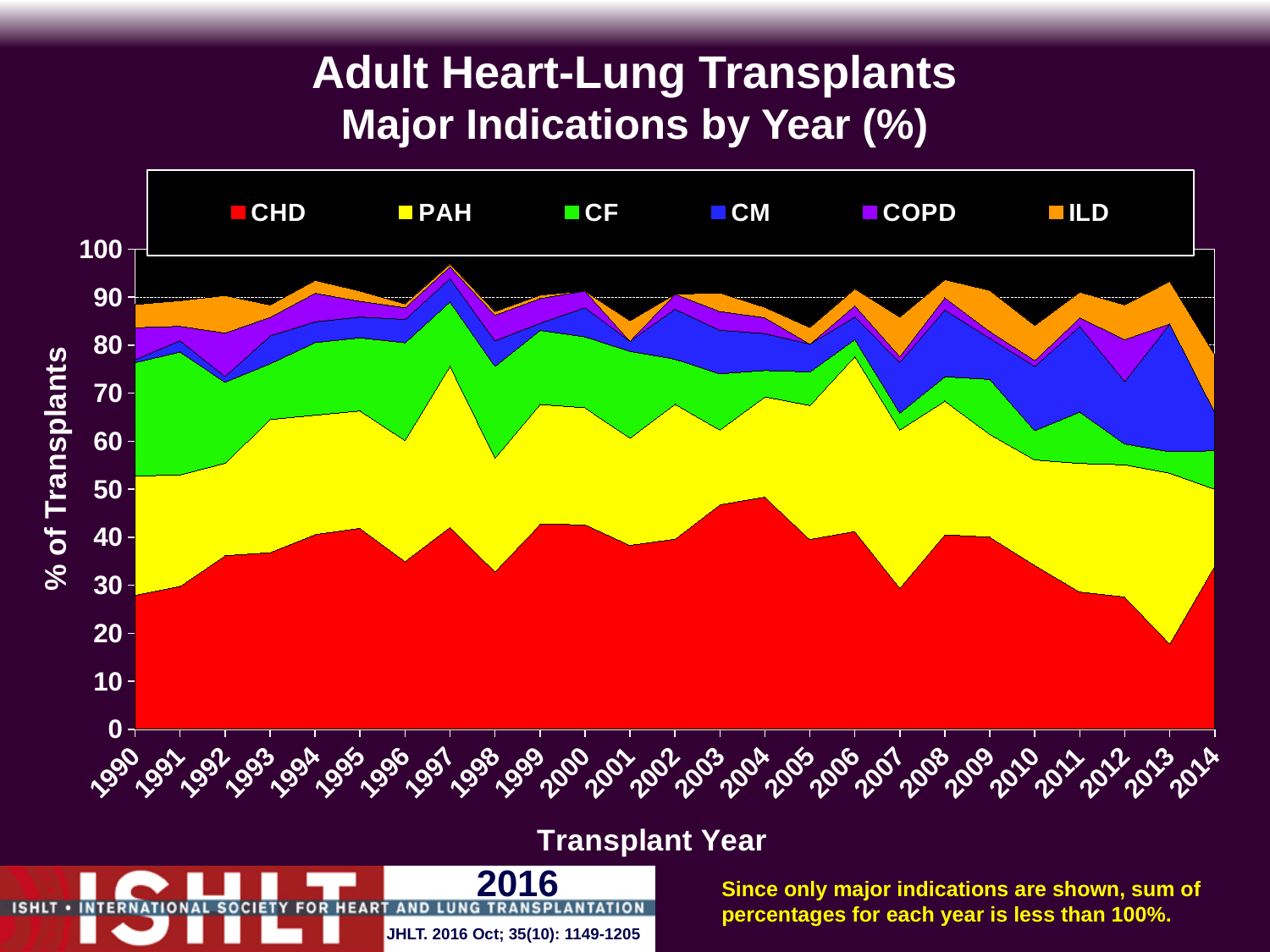
Which indication is shown in red in the chart? CHD Is the CHD percentage in 1990 greater or less than 40? less Is the combined percentage of all major indications in 2014 greater or less than 90? less In which year is the CHD percentage the highest? 2004 How many transplant years are plotted along the x axis? 25 Does the CHD percentage rise or fall from 2004 to 2013? fall How many series does the legend list? 6 Is the CHD percentage in 2004 greater or less than 40? greater What is the label of the y axis? % of Transplants In which year is the CHD percentage the lowest? 2013 What kind of chart is shown on the slide? Stacked area chart